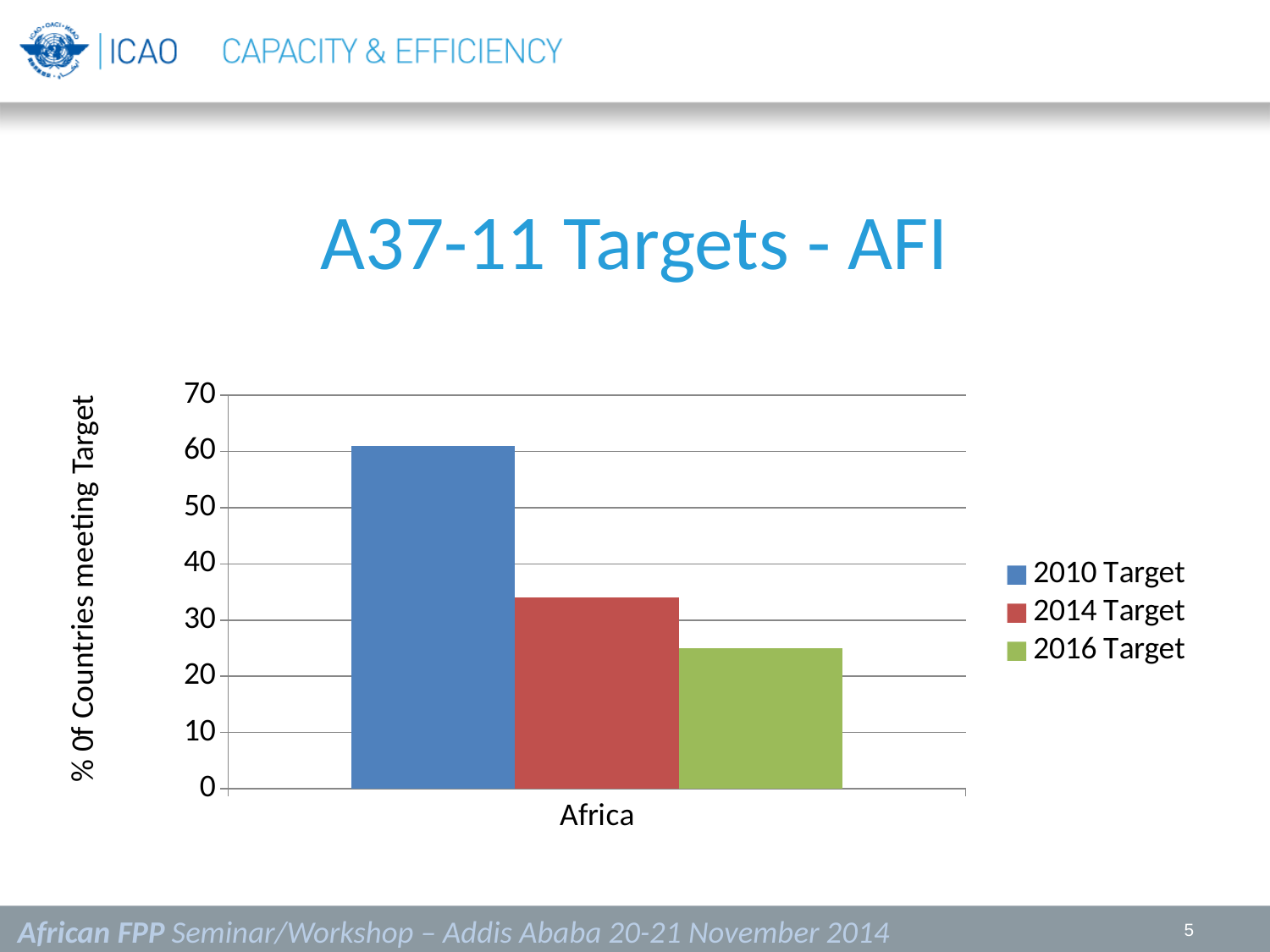
Is the value for 2014 Target greater or less than 30? greater Which is larger, the 2014 Target value or the 2016 Target value? 2014 Target What is the label on the vertical axis? % 0f Countries meeting Target Which series has the lowest value for Africa? 2016 Target How many series does the legend list? 3 What kind of chart is shown on the slide? bar chart How many categories are shown on the x axis? 1 Do the values fall or rise from the 2010 Target to the 2016 Target? fall Is the value for 2016 Target greater or less than 30? less Which series has the highest value for Africa? 2010 Target What is the title of the chart? A37-11 Targets - AFI